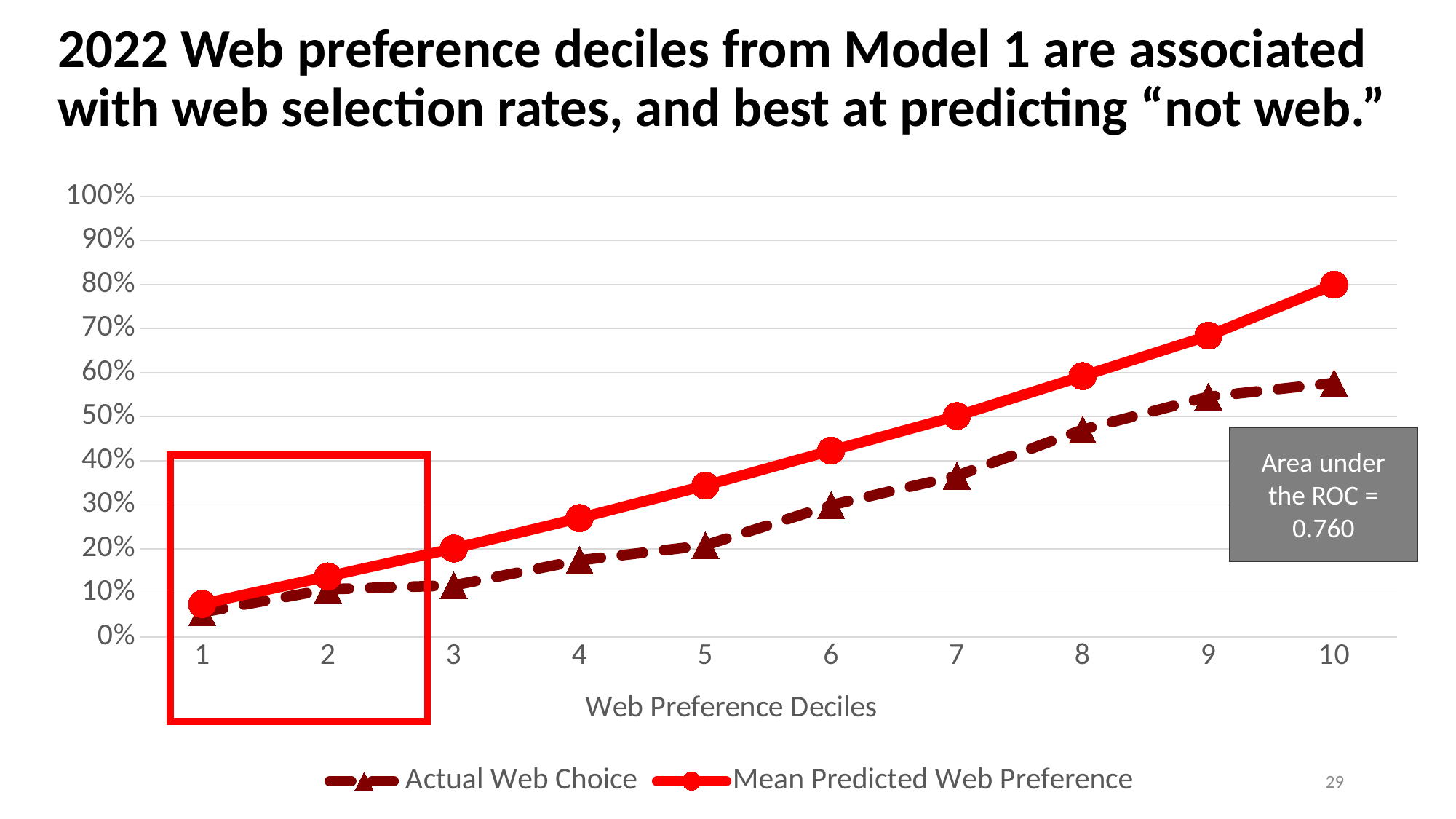
What is the title of the x axis? Web Preference Deciles What is the area under the ROC stated on the slide? 0.760 Is the Actual Web Choice value at decile 10 greater or less than 60%? less At which decile is Actual Web Choice highest? 10 Is the Actual Web Choice value at decile 6 greater or less than 40%? less Do the Mean Predicted Web Preference values rise or fall as the decile increases from 1 to 10? Rise Is the Mean Predicted Web Preference value at decile 10 greater or less than 70%? greater What kind of chart is shown on the slide? Line chart At decile 10, which series has the larger value, Actual Web Choice or Mean Predicted Web Preference? Mean Predicted Web Preference At which decile is Mean Predicted Web Preference lowest? 1 How many series does the legend list? 2 How many deciles are plotted along the x axis? 10